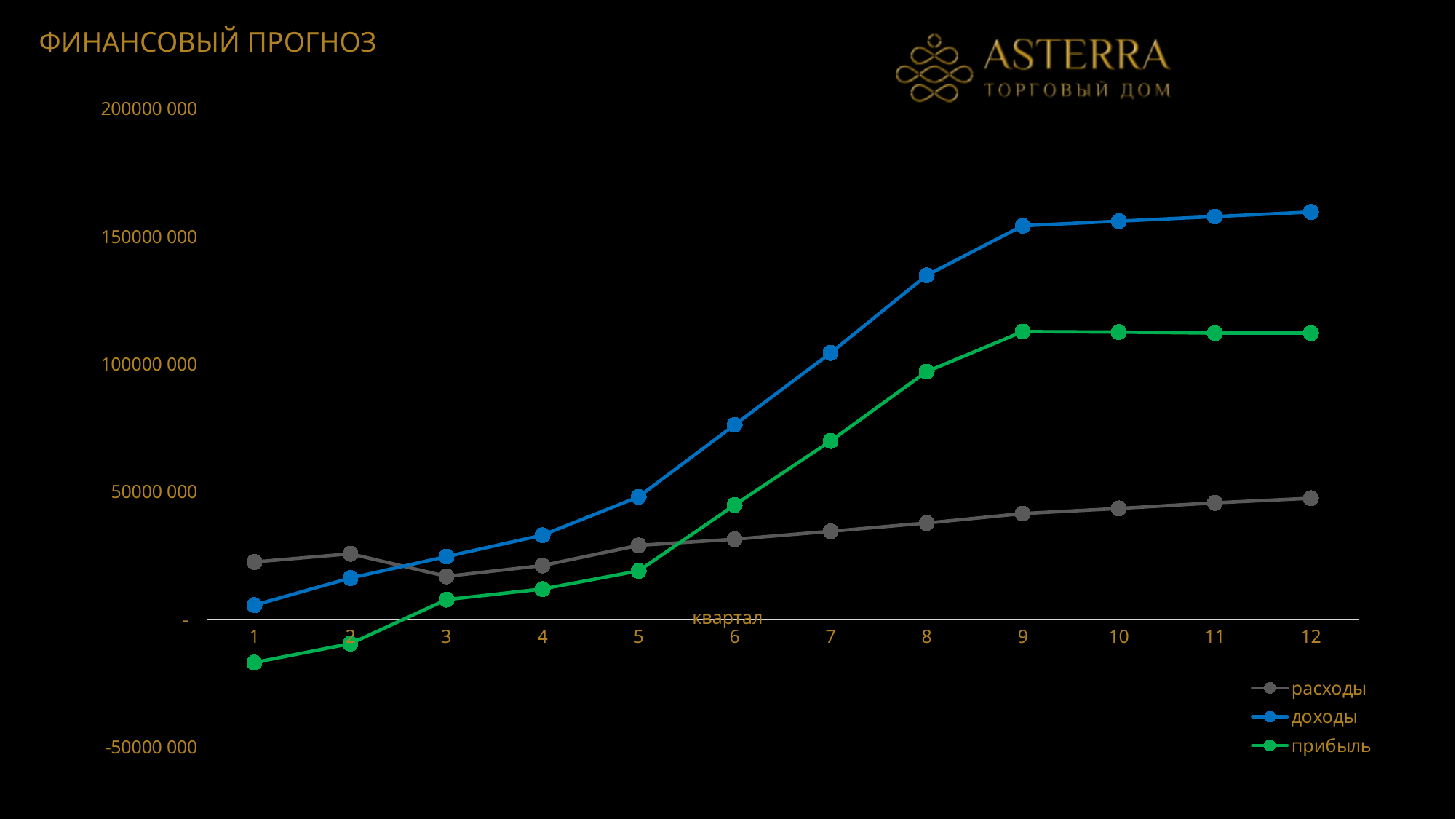
How many quarters are plotted along the x axis? 12 In which quarter is прибыль lowest? 1 Is the value of расходы in quarter 6 greater or less than 50000 000? less In which quarter is доходы highest? 12 Is the value of прибыль in quarter 9 greater or less than 50000 000? greater Is the value of доходы in quarter 12 greater or less than 150000 000? greater Does the доходы line rise or fall from quarter 1 to quarter 12? rise In quarter 1, which is larger: расходы or доходы? расходы How many series does the legend list? 3 What kind of chart is shown on the slide? line chart In quarter 8, which is larger: доходы or расходы? доходы